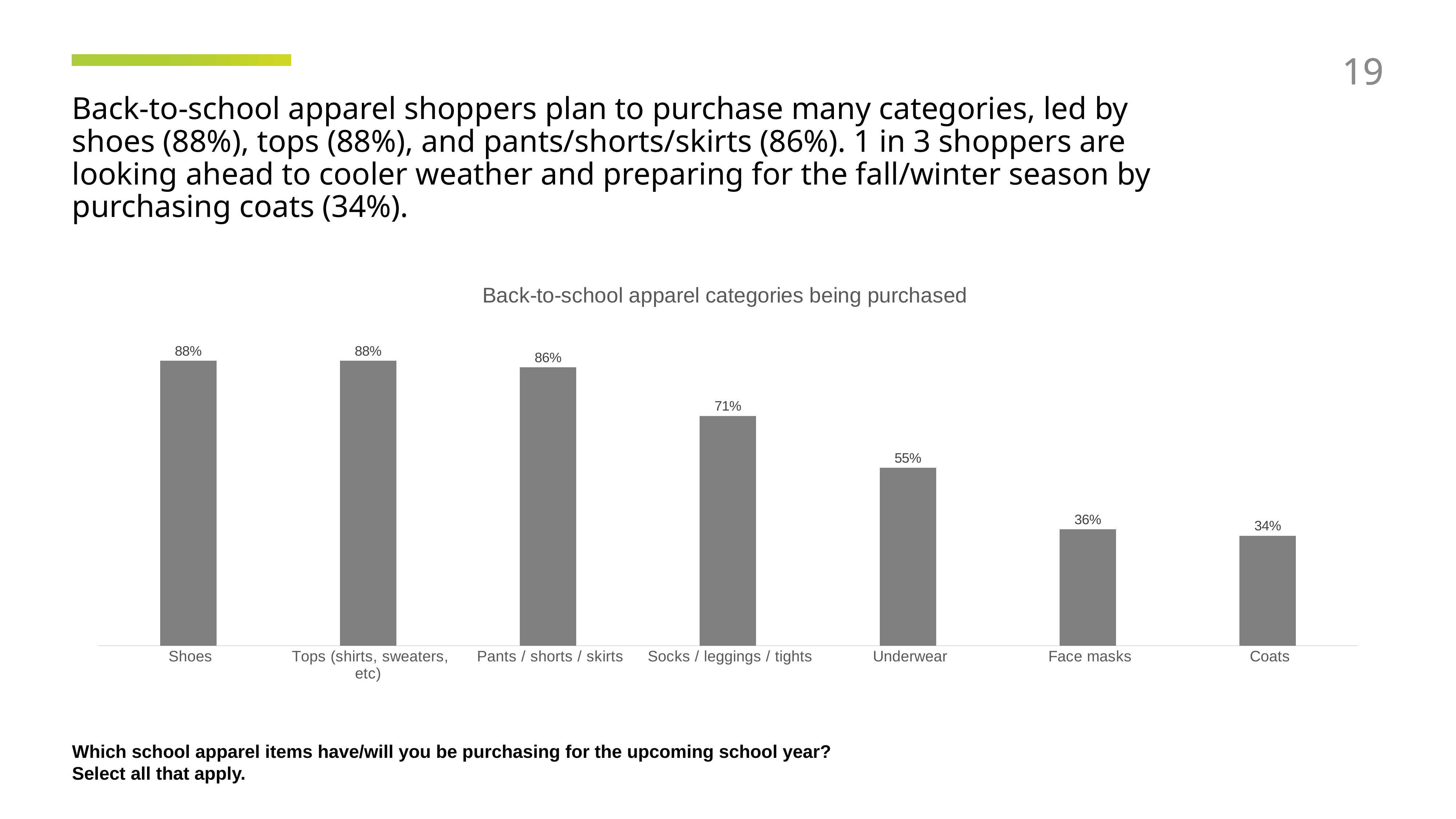
What is the value for Socks / leggings / tights? 71% What is the difference between the values for Pants / shorts / skirts and Coats? 52% What is the title of the chart? Back-to-school apparel categories being purchased Which category has the lowest value? Coats What is the value for Face masks? 36% Do the values rise or fall from left to right across the categories? Fall What is the value for Underwear? 55% What percentage of shoppers plan to purchase Shoes? 88% Which is larger, the value for Underwear or the value for Face masks? Underwear What kind of chart is shown on the slide? Bar chart What is the difference between the values for Socks / leggings / tights and Underwear? 16% How many categories are shown in the chart? 7